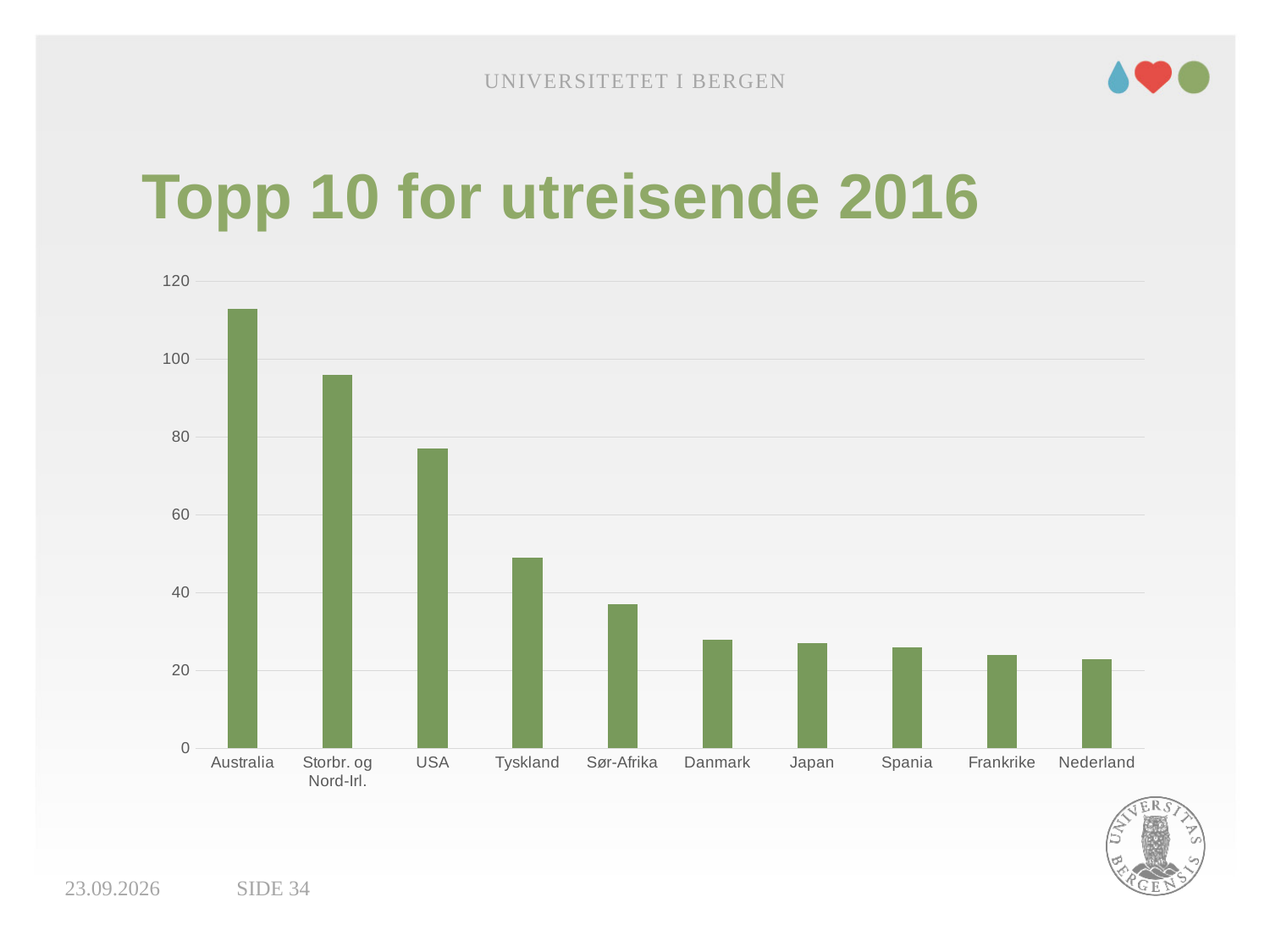
Is the value for Nederland greater or less than 20? greater Which is larger, the value for Sør-Afrika or the value for Spania? Sør-Afrika Which country has the highest bar in the chart? Australia Is the value for USA greater or less than 60? greater What kind of chart is shown on the slide? bar chart Which is larger, the value for USA or the value for Tyskland? USA How many countries are shown on the x axis of the chart? 10 Is the value for Storbr. og Nord-Irl. greater or less than 100? less What is the title of the chart? Topp 10 for utreisende 2016 Do the values rise or fall from left to right along the x axis? fall